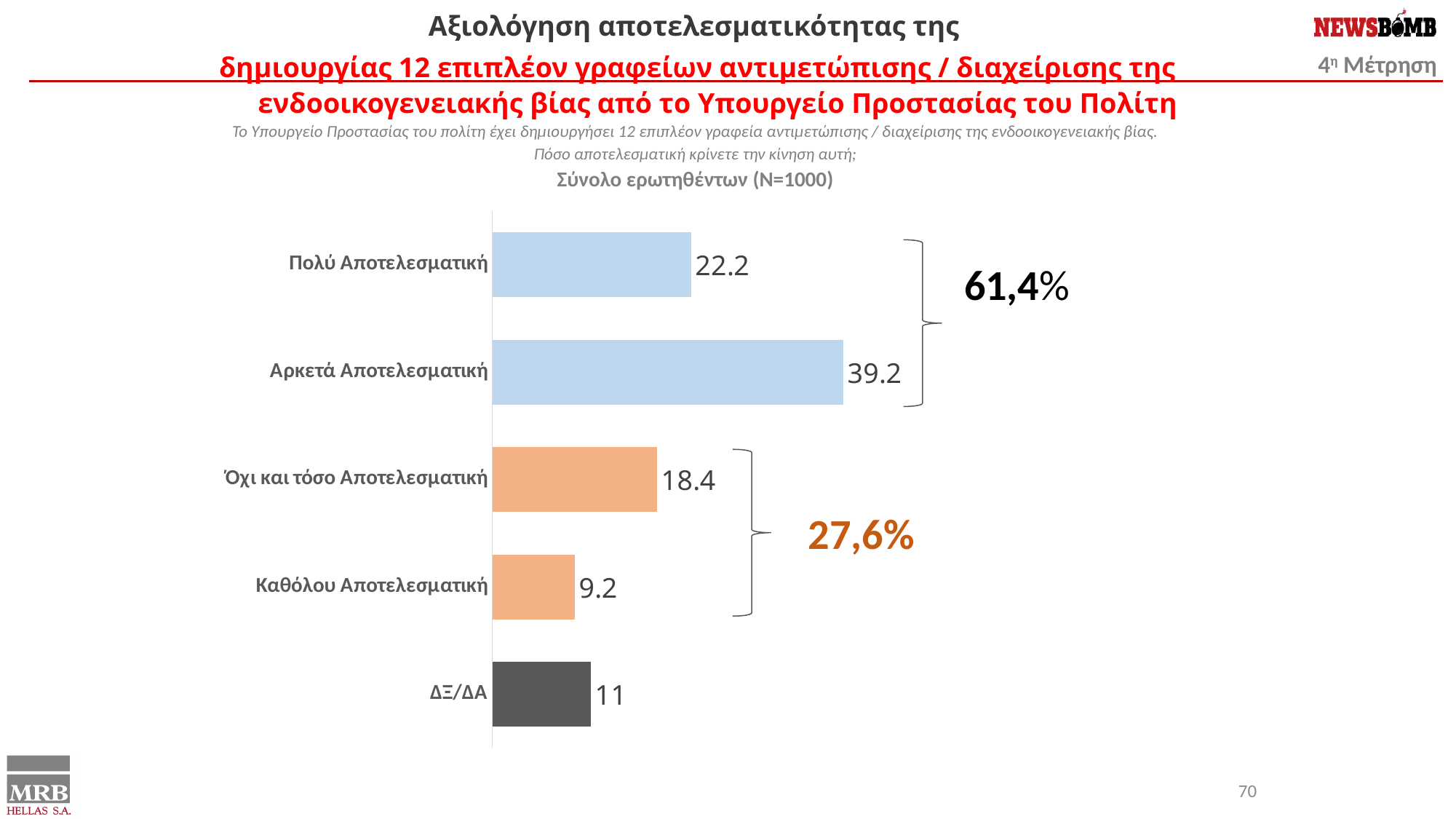
Which is larger, the value for Όχι και τόσο Αποτελεσματική or the value for ΔΞ/ΔΑ? Όχι και τόσο Αποτελεσματική What is the difference between the values for Αρκετά Αποτελεσματική and Πολύ Αποτελεσματική? 17 What is the value for Αρκετά Αποτελεσματική? 39.2 What is the value for ΔΞ/ΔΑ? 11 What is the value for Καθόλου Αποτελεσματική? 9.2 Which category has the highest value? Αρκετά Αποτελεσματική How many categories are shown in the chart? 5 What is the value for Πολύ Αποτελεσματική? 22.2 What kind of chart is shown on the slide? Bar chart What combined percentage is shown next to the bracket grouping Πολύ Αποτελεσματική and Αρκετά Αποτελεσματική? 61,4% What is the value for Όχι και τόσο Αποτελεσματική? 18.4 Which category has the lowest value? Καθόλου Αποτελεσματική